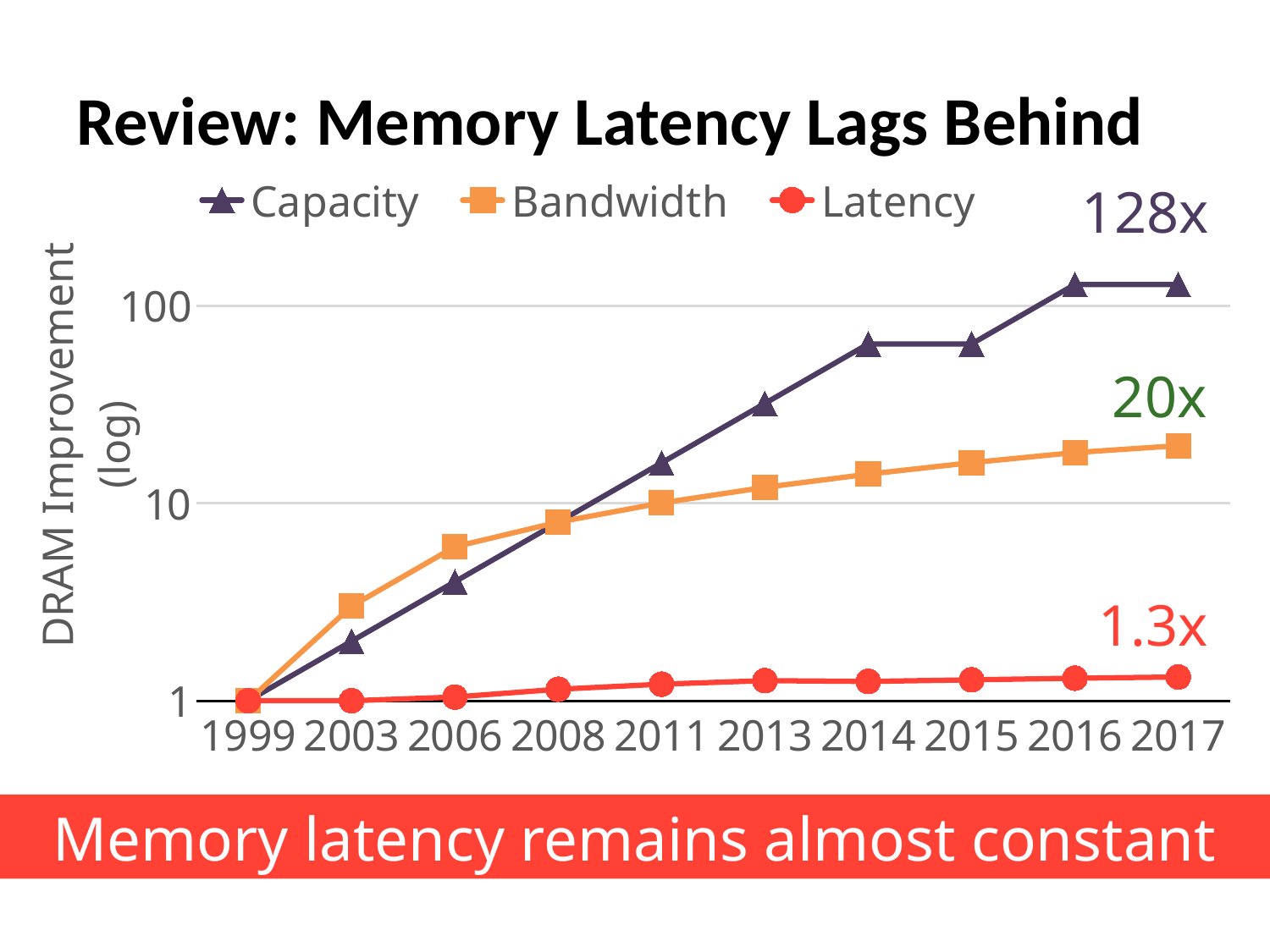
What is the improvement factor labelled for Latency in 2017? 1.3x What is the improvement factor labelled for Bandwidth in 2017? 20x What is the improvement factor labelled for Capacity in 2017? 128x How many series does the legend list? 3 How many years are shown on the x axis? 10 What is the y-axis title of the chart? DRAM Improvement (log) Does the Capacity series rise or fall from 1999 to 2017? rise What kind of chart is shown on the slide? line chart Which series has the highest value in 2017? Capacity In 2006, which is larger: Capacity or Bandwidth? Bandwidth Is the value for Capacity in 2013 greater or less than 10? greater Which series has the lowest value in 2017? Latency